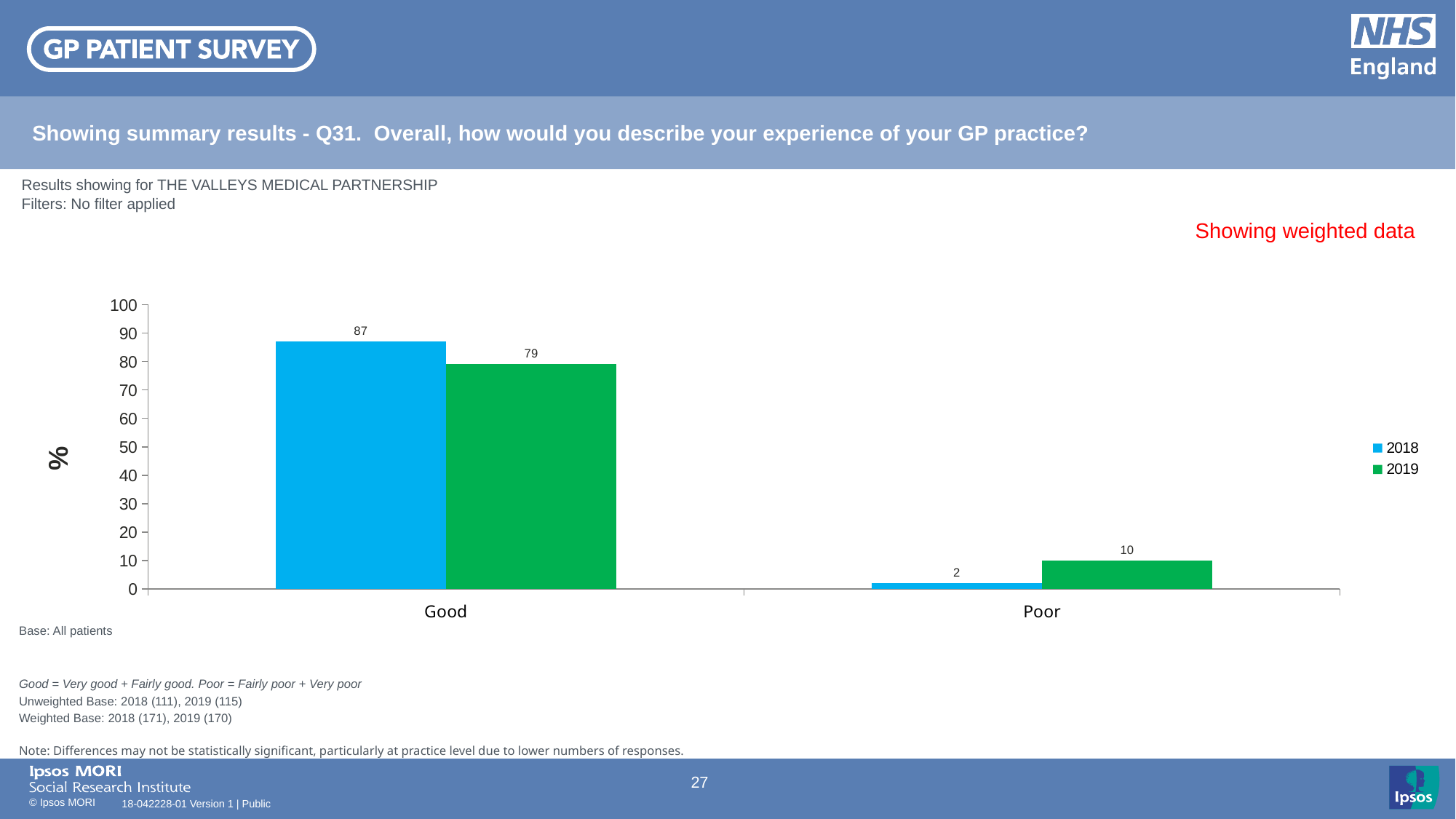
Which category has the lowest value in 2019? Poor Which category has the highest value in 2018? Good What is the difference between the 2018 and 2019 values for Good? 8 What is the value for Good in 2018? 87 Which is larger for Poor, the 2018 value or the 2019 value? 2019 What kind of chart is shown on the slide? Bar chart What is the value for Poor in 2019? 10 How many categories are shown on the x axis? 2 What is the difference between the 2019 and 2018 values for Poor? 8 What is the value for Good in 2019? 79 How many series does the legend list? 2 What is the value for Poor in 2018? 2